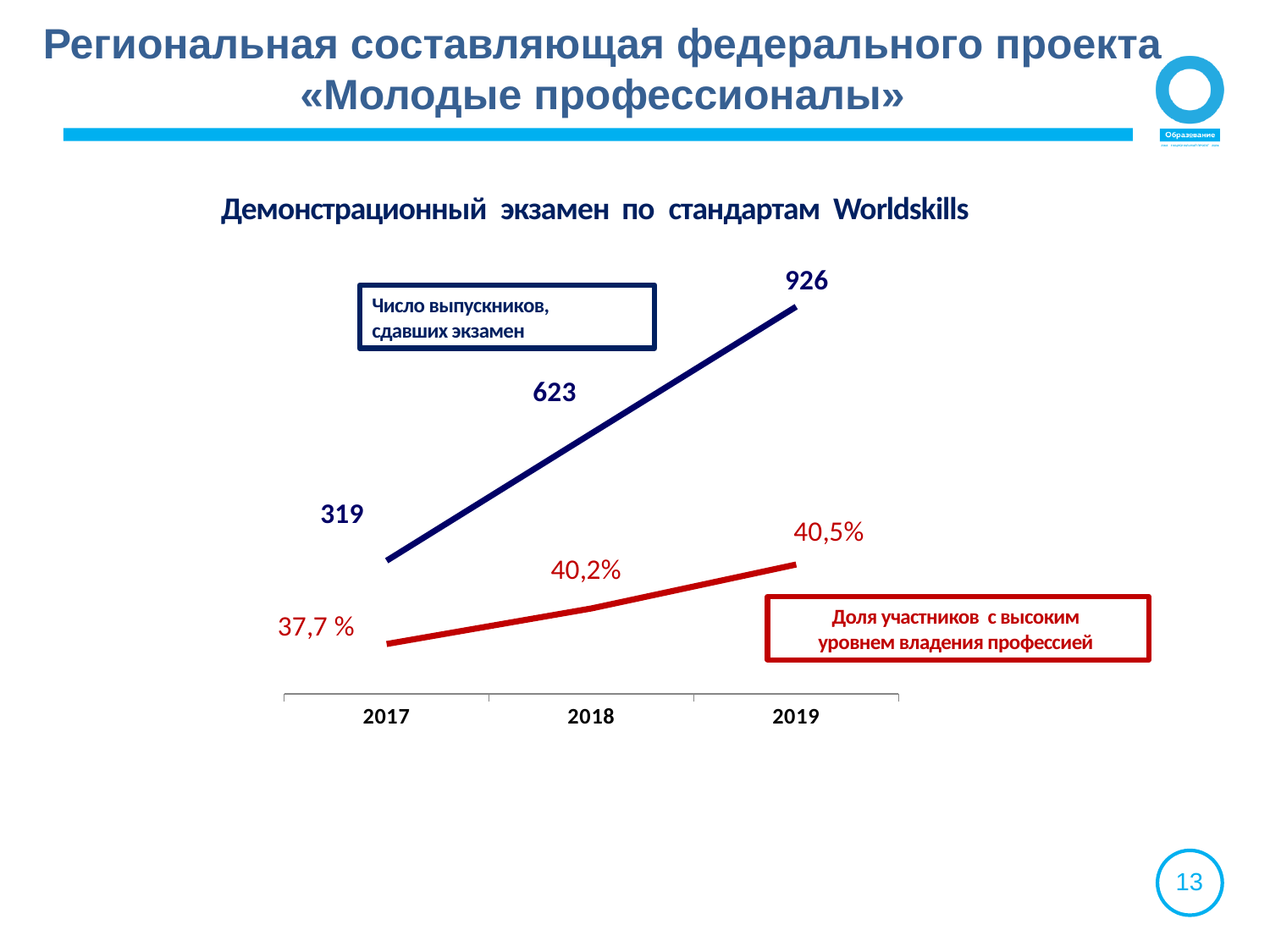
In which year is the share of participants with a high level of professional skill the lowest? 2017 How many years are shown on the x axis of the chart? 3 What is the share of participants with a high level of professional skill (Доля участников с высоким уровнем владения профессией) in 2019? 40,5% Does the number of graduates who passed the exam rise or fall from 2017 to 2019? rise What is the number of graduates who passed the exam (Число выпускников, сдавших экзамен) in 2018? 623 What type of chart is shown on the slide? line chart What is the title of the chart? Демонстрационный экзамен по стандартам Worldskills In which year is the number of graduates who passed the exam the highest? 2019 By how much did the number of graduates who passed the exam increase from 2017 to 2019? 607 What is the share of participants with a high level of professional skill (Доля участников с высоким уровнем владения профессией) in 2017? 37,7 % What is the number of graduates who passed the exam (Число выпускников, сдавших экзамен) in 2017? 319 What is the number of graduates who passed the exam (Число выпускников, сдавших экзамен) in 2019? 926